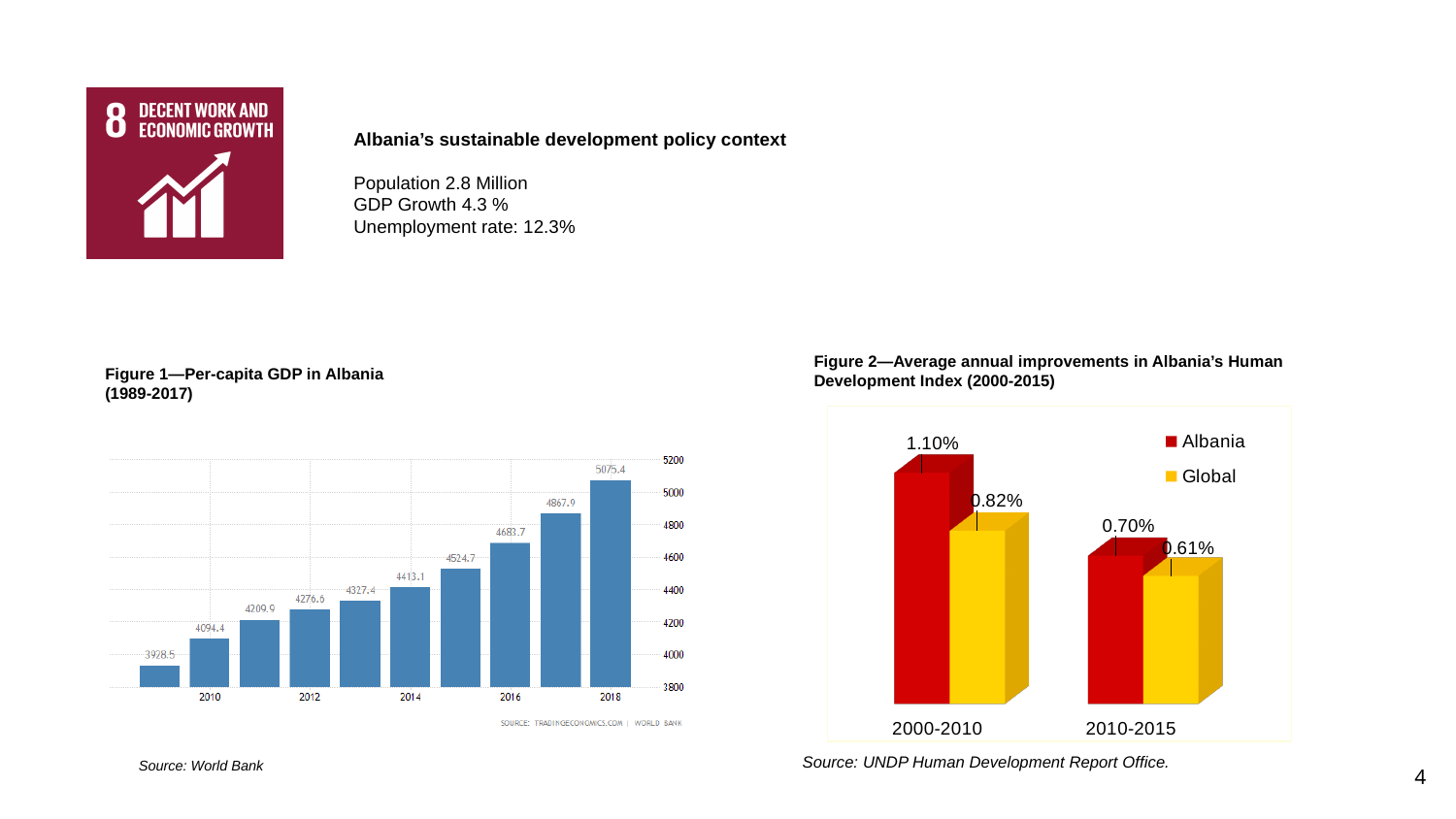
In Figure 2 (Average annual improvements in Albania's Human Development Index), what is the Albania value for 2000-2010? 1.10% In Figure 2 (Average annual improvements in Albania's Human Development Index), what is the Global value for 2010-2015? 0.61% In Figure 2 (Average annual improvements in Albania's Human Development Index), which is larger for 2010-2015, Albania or Global? Albania In Figure 1 (Per-capita GDP in Albania), what is the value for 2018? 5075.4 In Figure 2 (Average annual improvements in Albania's Human Development Index), how many series does the legend list? 2 In Figure 1 (Per-capita GDP in Albania), how many bars are plotted? 10 In Figure 1 (Per-capita GDP in Albania), is the value for 2012 greater or less than 4400? less In Figure 2 (Average annual improvements in Albania's Human Development Index), what is the difference between the Albania and Global values for 2000-2010? 0.28% In Figure 1 (Per-capita GDP in Albania), what is the difference between the 2018 value and the 2016 value? 391.7 In Figure 1 (Per-capita GDP in Albania), which year has the highest value? 2018 In Figure 1 (Per-capita GDP in Albania), what is the value for 2014? 4413.1 In Figure 1 (Per-capita GDP in Albania), do the values rise or fall from 2010 to 2018? rise